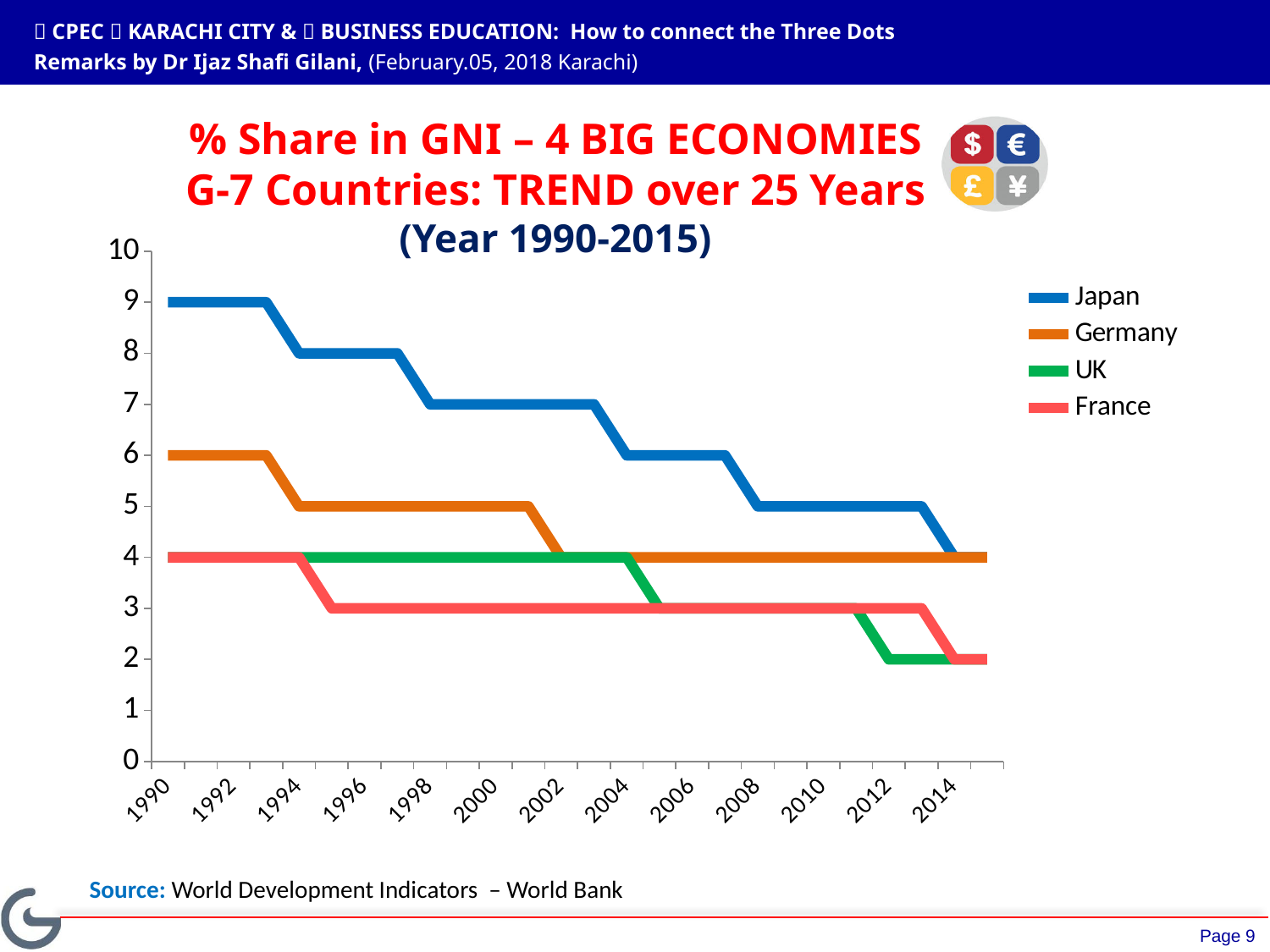
By how much did Japan's value fall between 1990 and 2014? 5 Is the value for Japan in 2000 greater or less than 5? greater What is the value for UK in 2014? 2 Which series is drawn in green? UK Does the value for Japan rise or fall from 1990 to 2014? fall What kind of chart is shown on the slide? line chart What is the value for Japan in 2014? 4 How many series does the legend list? 4 Which country has the highest value in 1990? Japan What is the value for Germany in 1990? 6 What is the value for Japan in 1990? 9 Which is larger in 2000, the value for Japan or the value for Germany? Japan